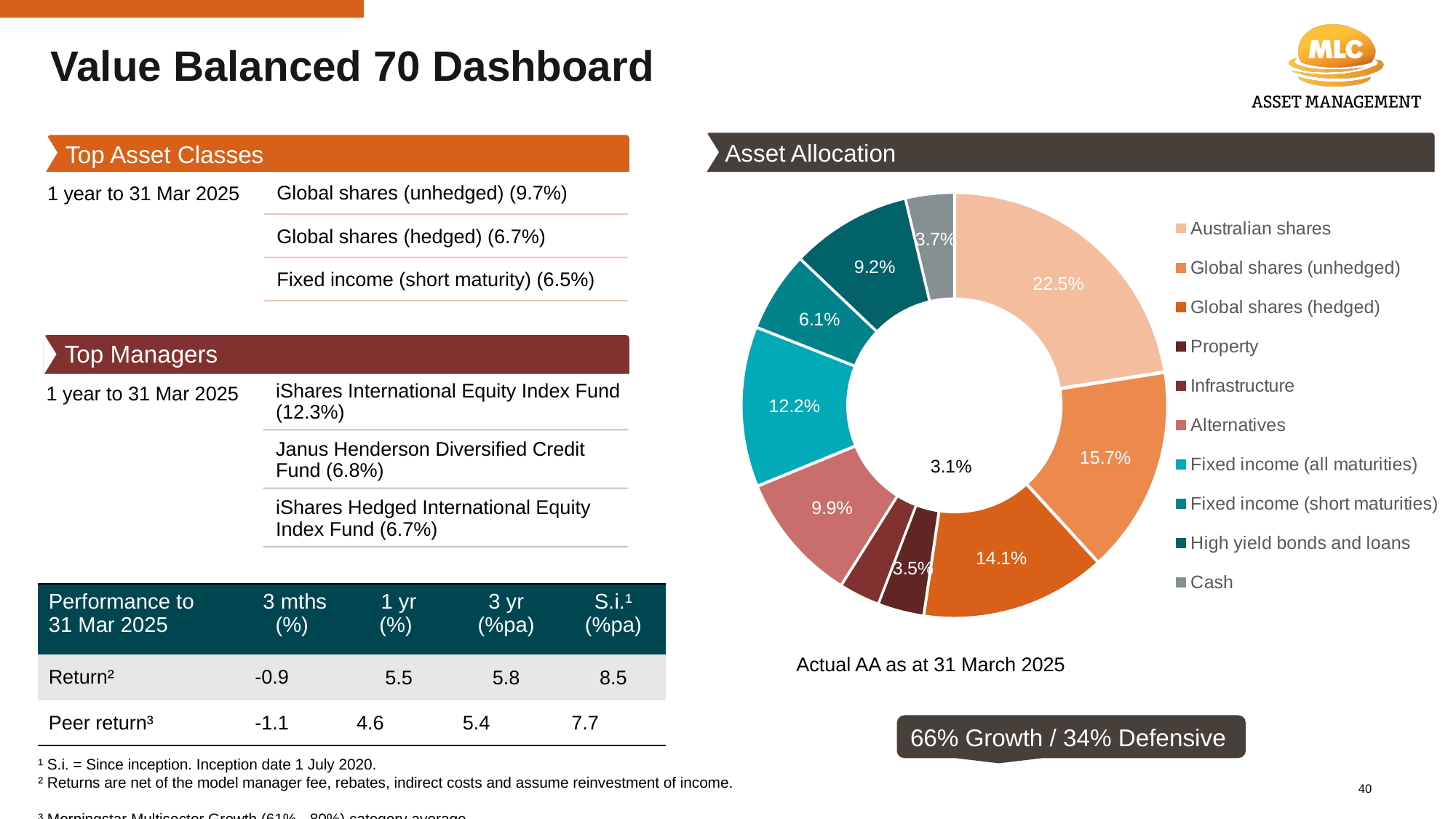
In the Asset Allocation chart, which is larger: the allocation to Alternatives or to High yield bonds and loans? Alternatives In the Asset Allocation chart, what share is allocated to Fixed income (all maturities)? 12.2% How many asset classes are listed in the legend of the Asset Allocation chart? 10 What kind of chart is shown under the Asset Allocation heading? Pie (donut) chart In the Asset Allocation chart, which asset class has the smallest allocation? Infrastructure In the Asset Allocation chart, which asset class has the largest allocation? Australian shares In the Asset Allocation chart, what share is allocated to Global shares (hedged)? 14.1% In the Asset Allocation chart, what share is allocated to Global shares (unhedged)? 15.7% What date is the Asset Allocation chart stated to be as at? 31 March 2025 In the Asset Allocation chart, what share is allocated to Cash? 3.7% In the Asset Allocation chart, what share is allocated to Australian shares? 22.5% In the Asset Allocation chart, what is the difference between the Australian shares allocation and the Global shares (unhedged) allocation? 6.8%